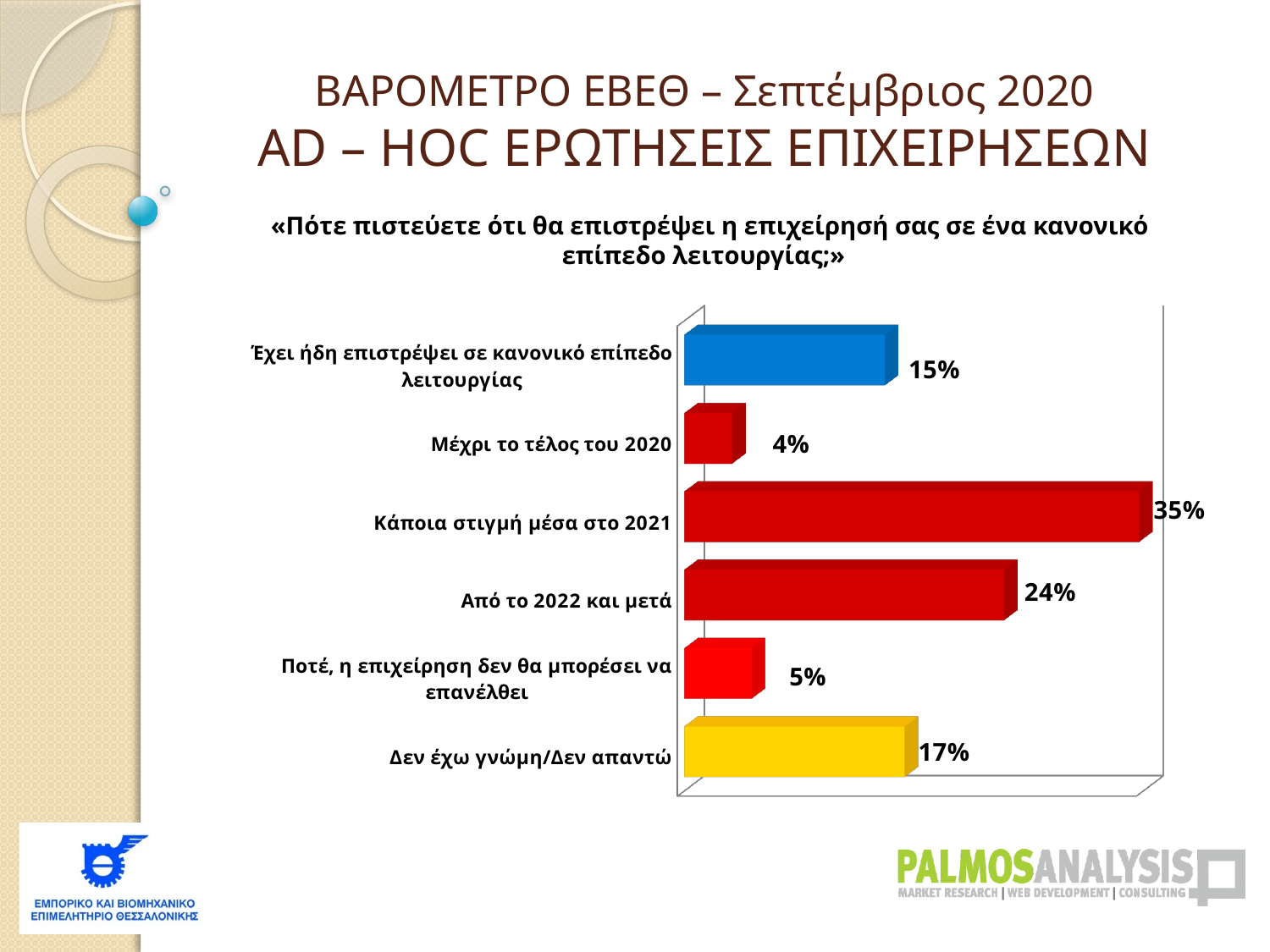
Which is larger: the value for "Δεν έχω γνώμη/Δεν απαντώ" or for "Έχει ήδη επιστρέψει σε κανονικό επίπεδο λειτουργίας"? Δεν έχω γνώμη/Δεν απαντώ What is the value for "Από το 2022 και μετά"? 24% How many categories are shown in the chart? 6 What is the value for "Έχει ήδη επιστρέψει σε κανονικό επίπεδο λειτουργίας"? 15% What is the value for "Δεν έχω γνώμη/Δεν απαντώ"? 17% What is the difference between the values for "Ποτέ, η επιχείρηση δεν θα μπορέσει να επανέλθει" and "Μέχρι το τέλος του 2020"? 1% What percentage of businesses answered "Κάποια στιγμή μέσα στο 2021"? 35% What is the difference between the values for "Κάποια στιγμή μέσα στο 2021" and "Από το 2022 και μετά"? 11% What colour is the bar for "Δεν έχω γνώμη/Δεν απαντώ"? Yellow Which category has the lowest value? Μέχρι το τέλος του 2020 What kind of chart is shown on the slide? Bar chart Which category has the highest value? Κάποια στιγμή μέσα στο 2021